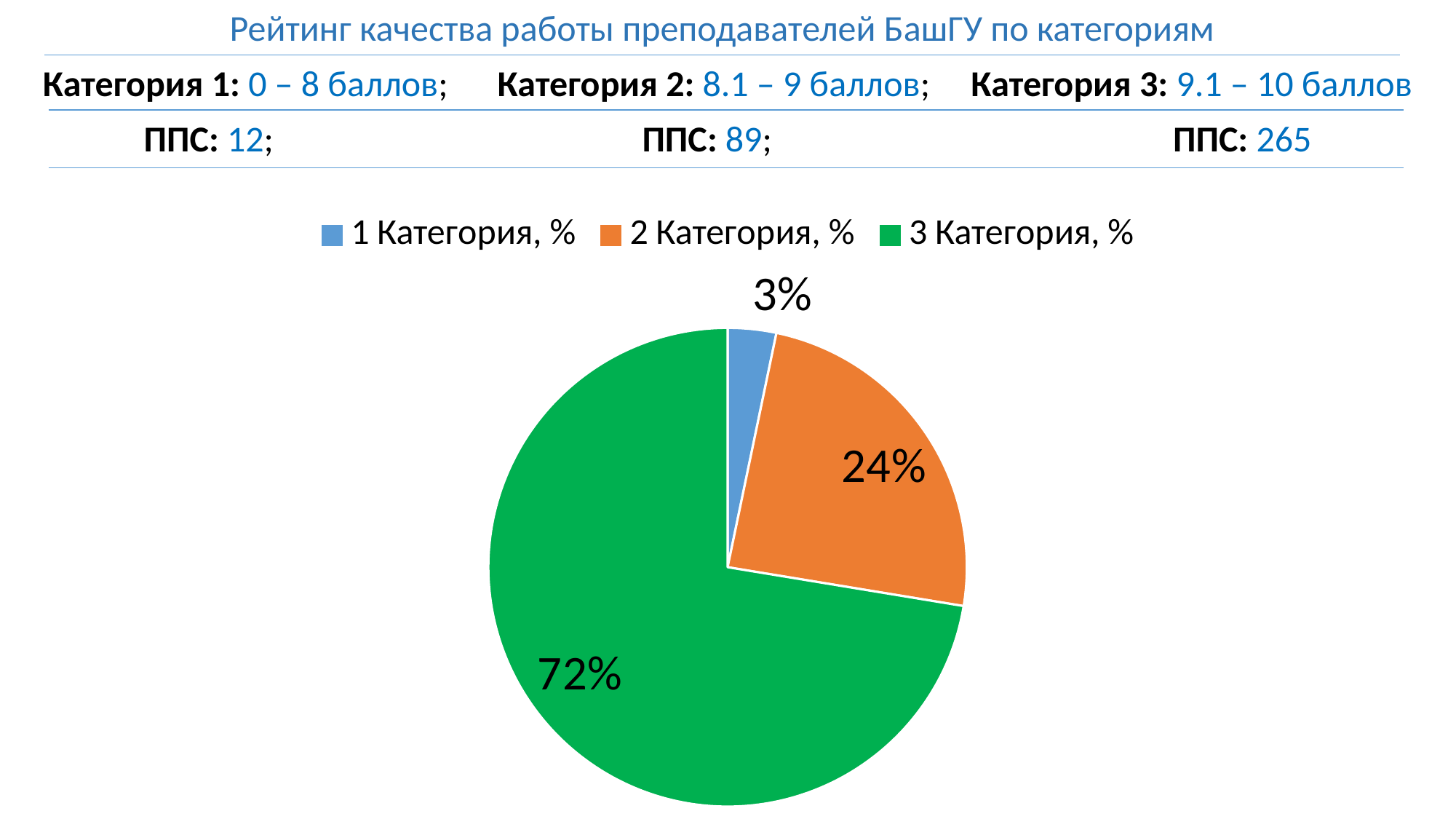
How many slices does the pie chart have? 3 What colour is the slice for "3 Категория, %"? green What share of the pie does "3 Категория, %" have? 72% What share of the pie does "1 Категория, %" have? 3% Which category has the largest slice of the pie? 3 Категория, % What kind of chart is shown on the slide? pie chart What is the difference in percentage points between the slices for "3 Категория, %" and "2 Категория, %"? 48 Which category has the smallest slice of the pie? 1 Категория, % What is the difference in percentage points between the slices for "2 Категория, %" and "1 Категория, %"? 21 How many entries does the legend list? 3 Which slice is larger, "2 Категория, %" or "1 Категория, %"? 2 Категория, % What share of the pie does "2 Категория, %" have? 24%